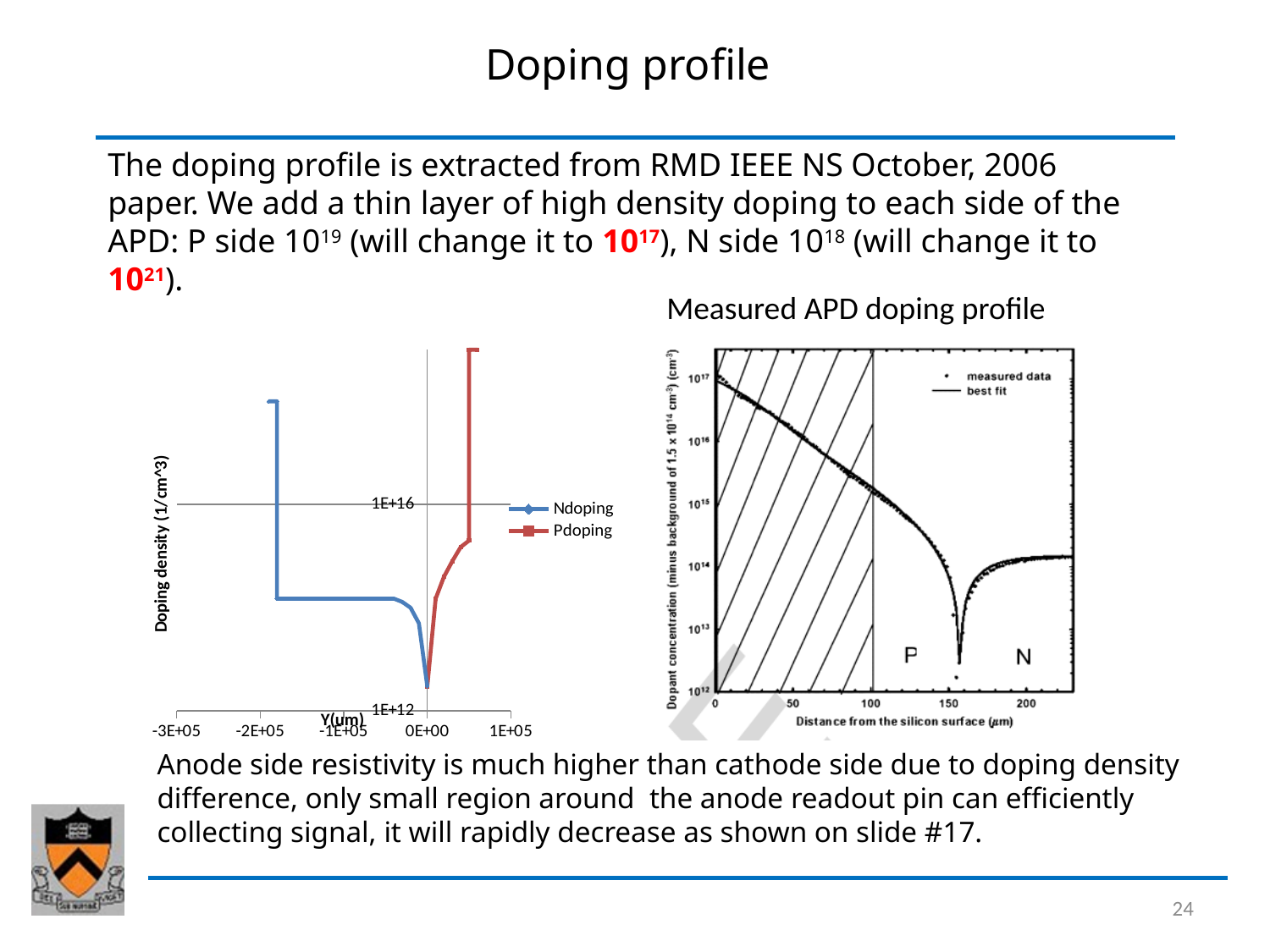
On the 'Measured APD doping profile' chart, is the dopant concentration at 200 μm greater or less than 10^15? less On the 'Measured APD doping profile' chart, is the dopant concentration at 0 μm greater or less than 10^16? greater On the 'Measured APD doping profile' chart, does the dopant concentration rise or fall as distance increases from 0 to 150 μm? fall On the 'Measured APD doping profile' chart, which region label appears to the right of the minimum, P or N? N On the left chart, how many series does the legend list? 2 On the 'Measured APD doping profile' chart, what two entries does the legend list? measured data, best fit On the left chart, which series is drawn in blue? Ndoping On the left chart, is the Pdoping value at its highest point greater or less than 1E+16? greater What kind of chart is the left chart with Ndoping and Pdoping? Line chart On the left chart, which series reaches the higher maximum doping density, Ndoping or Pdoping? Pdoping